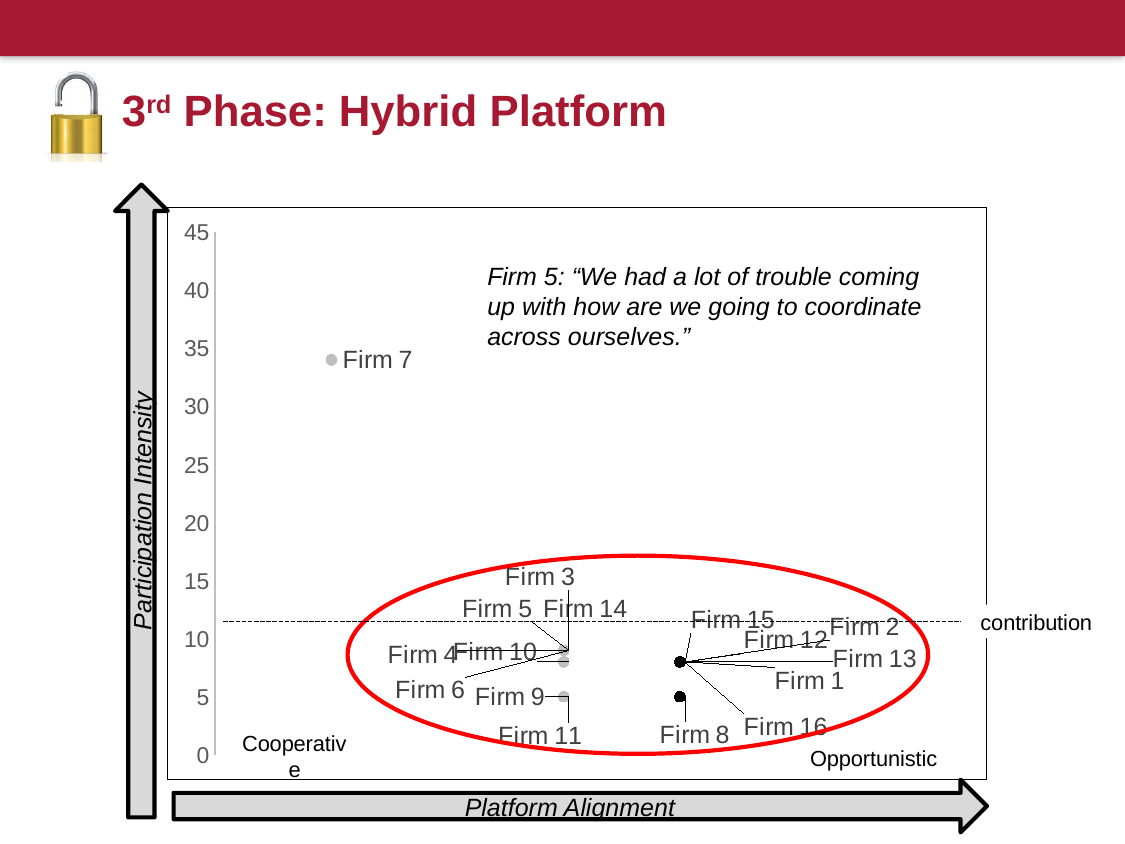
What is the title of the horizontal axis? Platform Alignment Which has a higher Participation Intensity, Firm 7 or Firm 13? Firm 7 What is the highest value shown on the vertical axis? 45 Is the Participation Intensity for Firm 7 greater or less than 30? greater Is the Participation Intensity for Firm 8 greater or less than 10? less Which has a higher Participation Intensity, Firm 7 or Firm 8? Firm 7 How many firms are labelled on the chart? 16 What kind of chart is shown on the slide? scatter chart Which firm has the highest Participation Intensity? Firm 7 Is the Participation Intensity for Firm 1 greater or less than 15? less